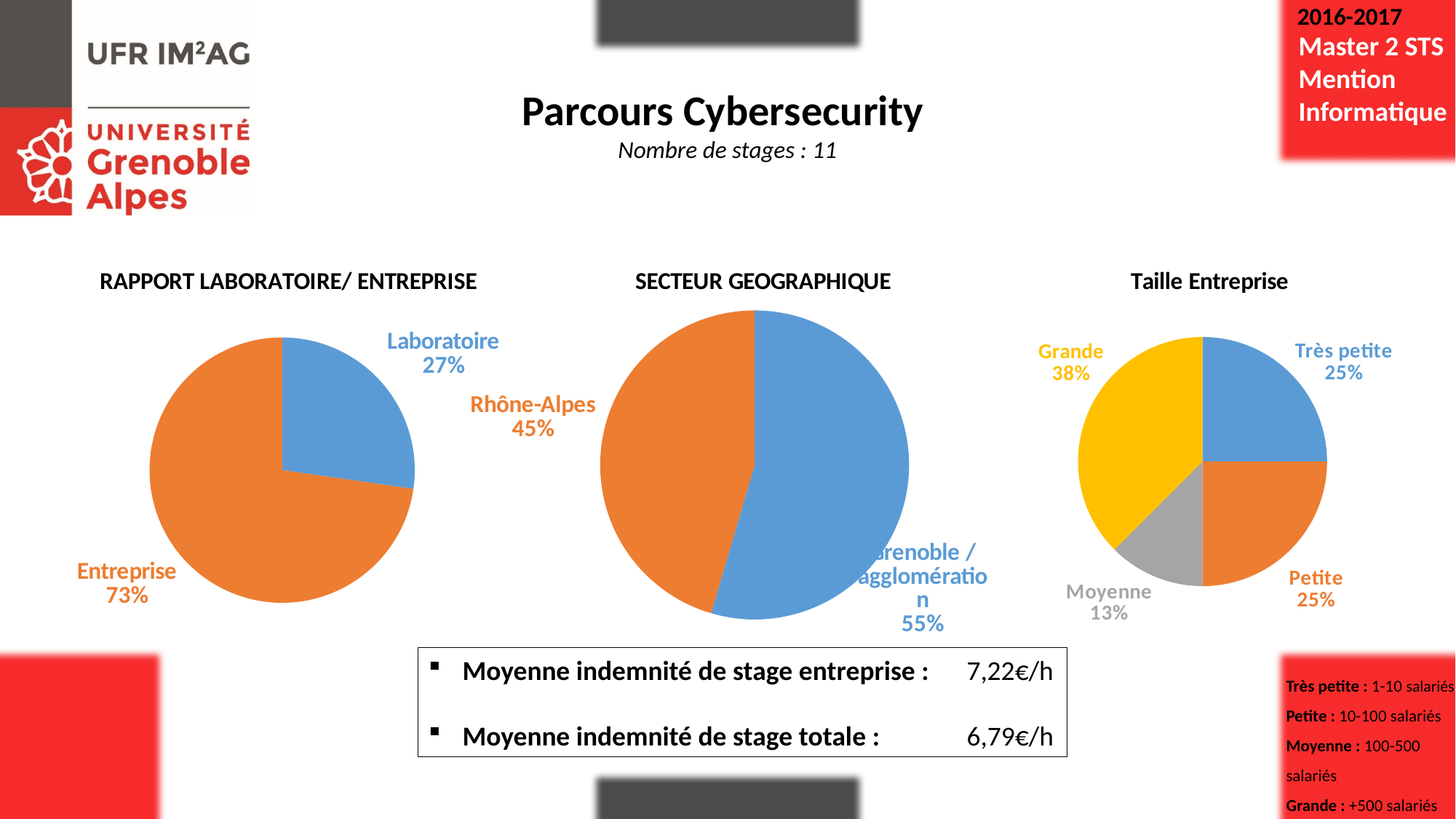
In the Taille Entreprise chart, which is larger, Grande or Petite? Grande In the Taille Entreprise chart, how many slices are there? 4 In the SECTEUR GEOGRAPHIQUE chart, what share does Grenoble / agglomération have? 55% In the Taille Entreprise chart, which slice is the smallest? Moyenne In the RAPPORT LABORATOIRE/ ENTREPRISE chart, what share does Laboratoire have? 27% In the RAPPORT LABORATOIRE/ ENTREPRISE chart, what share does Entreprise have? 73% What kind of chart is the SECTEUR GEOGRAPHIQUE chart? Pie chart In the RAPPORT LABORATOIRE/ ENTREPRISE chart, which slice is the largest? Entreprise In the SECTEUR GEOGRAPHIQUE chart, what is the difference between the Grenoble / agglomération share and the Rhône-Alpes share? 10%